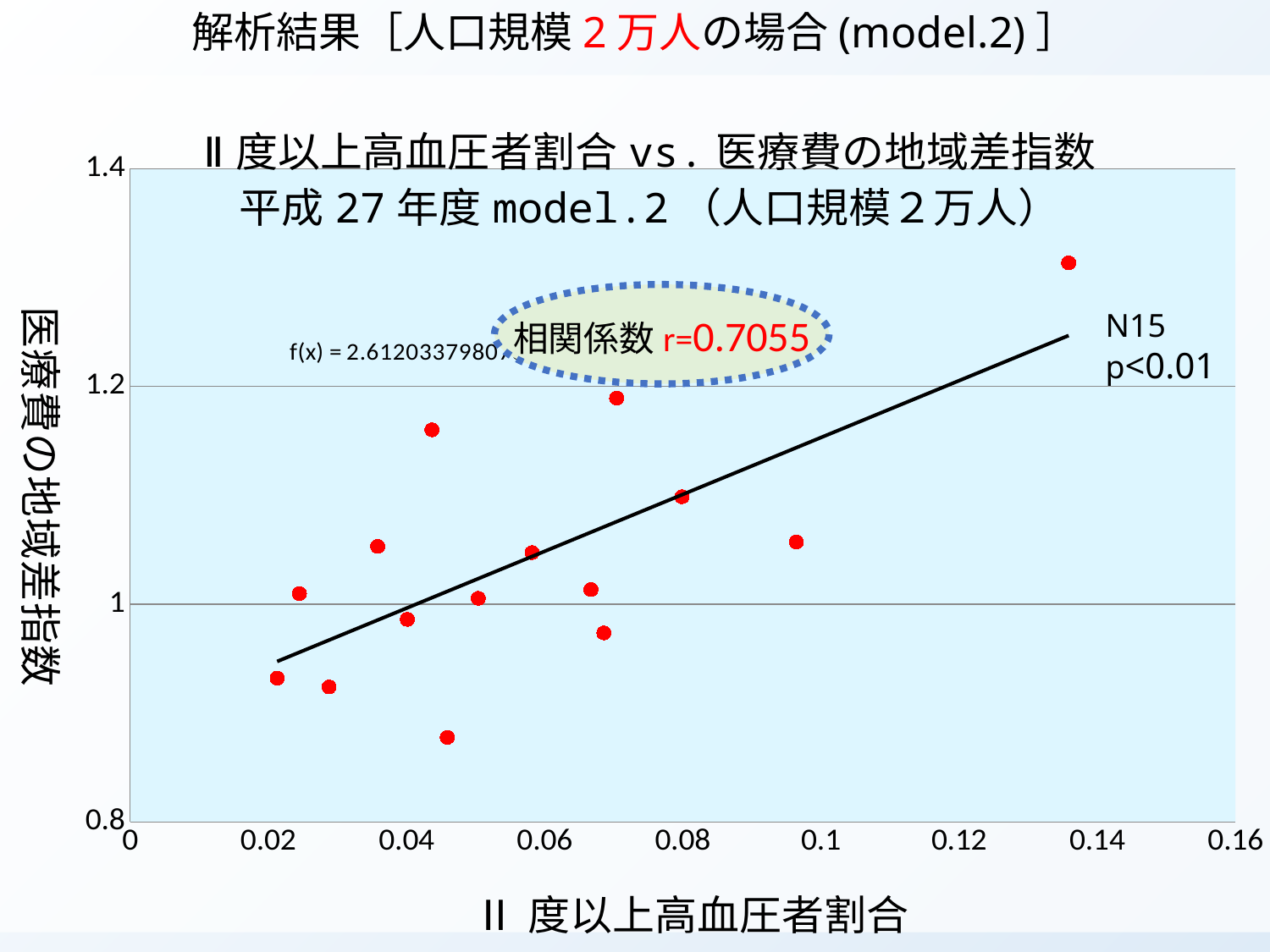
Does the trend line rise or fall as the Ⅱ度以上高血圧者割合 increases along the x axis? rises What is the maximum value shown on the y axis? 1.4 What kind of chart is shown on the slide? scatter plot What correlation coefficient (r) is shown on the chart? r=0.7055 What is the maximum value shown on the x axis? 0.16 Is the 医療費の地域差指数 value of the rightmost data point (near x = 0.14) greater or less than 1.2? greater Is the x value of the leftmost data point greater or less than 0.04? less Is the 医療費の地域差指数 value of the lowest data point greater or less than 1? less How many data points are plotted in the scatter chart? 15